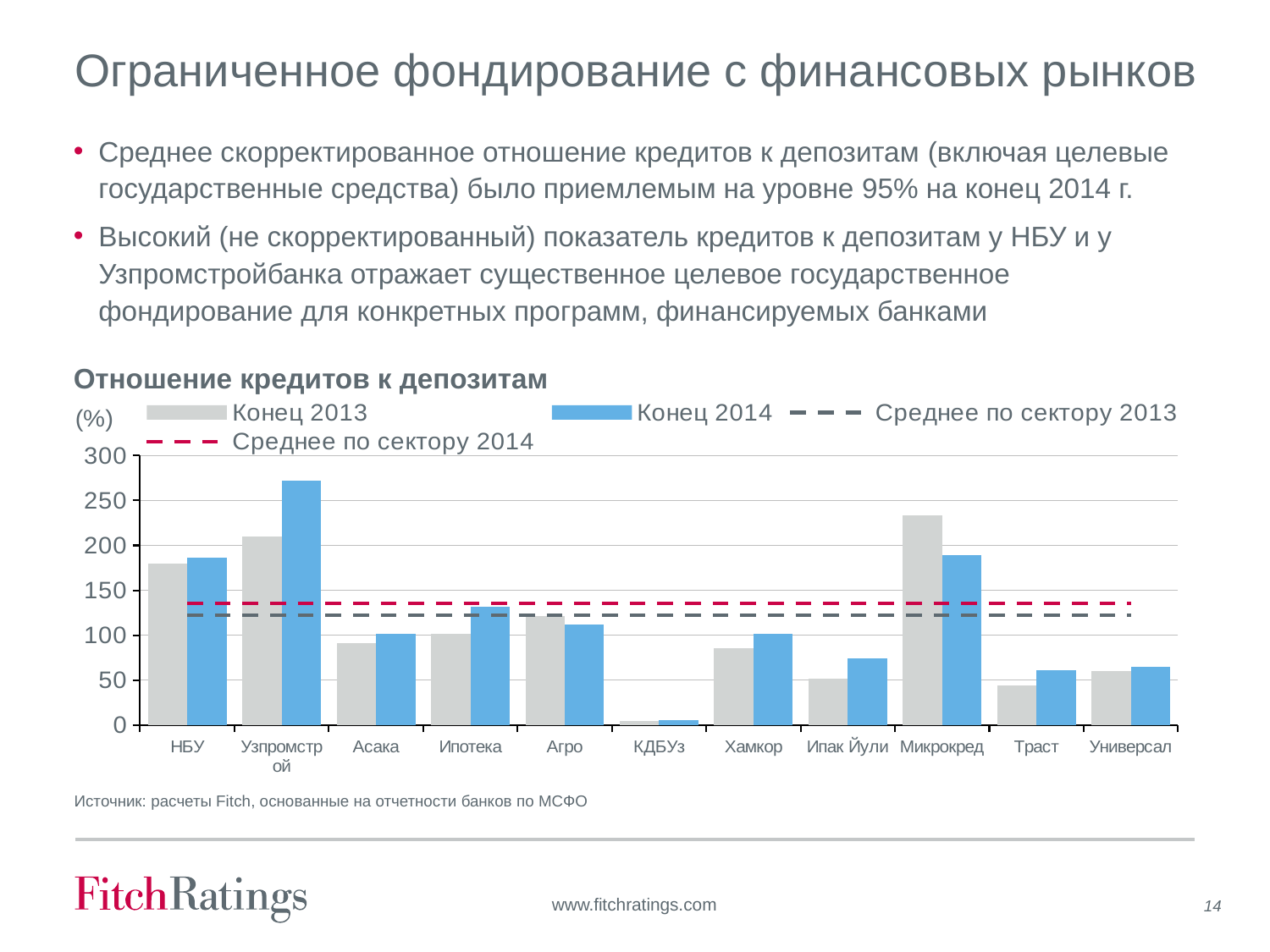
How many entries does the chart's legend list? 4 How many banks (categories) are shown on the x axis of the chart? 11 Is the "Конец 2014" value for Узпромстрой greater or less than 250? greater Which bank has the highest "Конец 2014" value in the chart? Узпромстрой Is the "Конец 2014" value for Ипак Йули greater or less than 50? greater What unit is shown on the y axis of the chart? (%) What kind of chart is shown under the title "Отношение кредитов к депозитам"? bar chart Which bank has the lowest "Конец 2014" value in the chart? КДБУз Which bank has the highest "Конец 2013" value in the chart? Микрокред Is the "Конец 2013" value for Микрокред greater or less than 200? greater For Микрокред, which is larger: the "Конец 2013" value or the "Конец 2014" value? Конец 2013